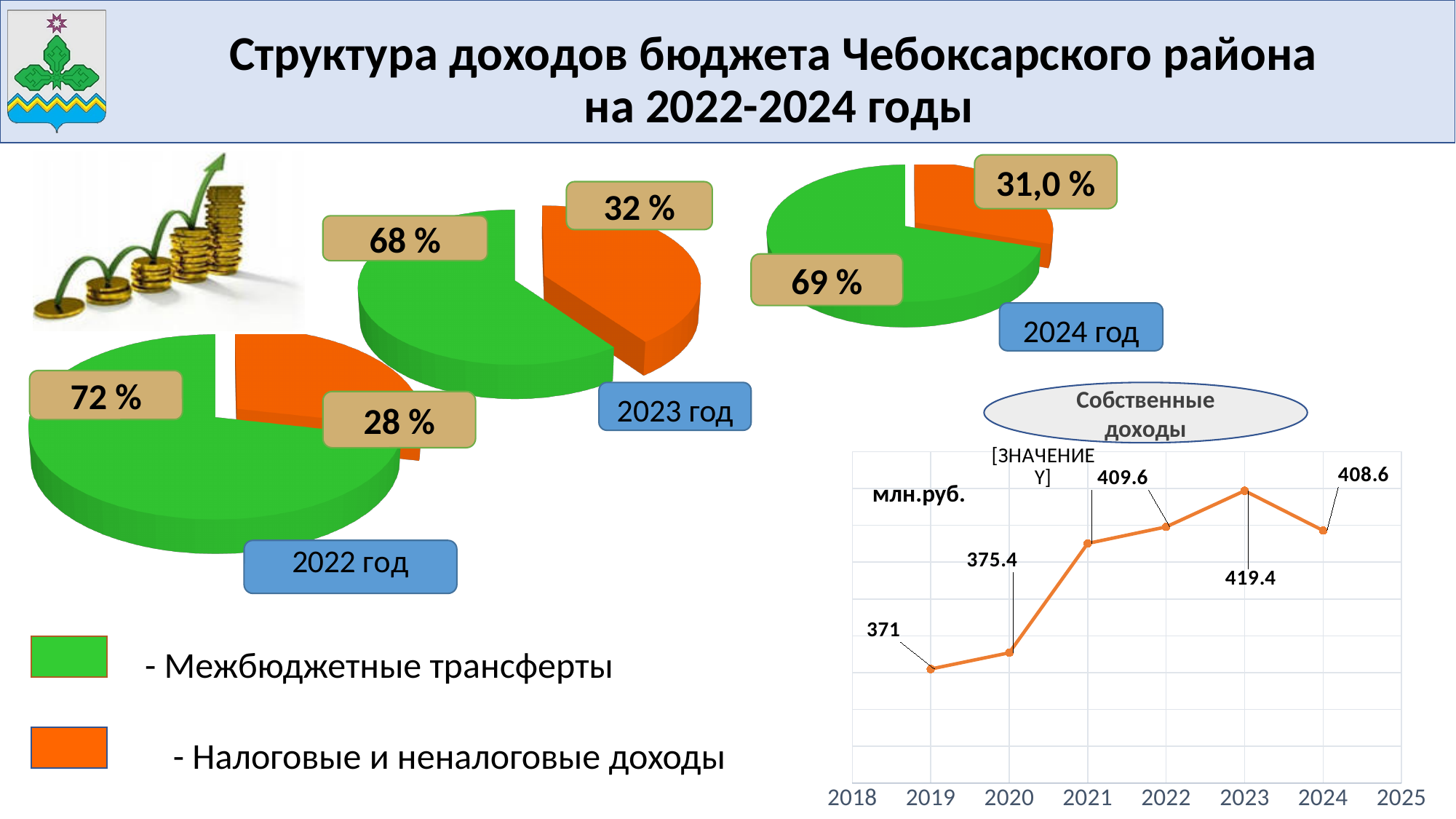
In the 2024 год pie chart, which category has the larger slice? Межбюджетные трансферты In the Собственные доходы line chart, which year has the highest value? 2023 In the Собственные доходы line chart, what is the value for 2019? 371 In the Собственные доходы line chart, what is the value for 2024? 408.6 In the Собственные доходы line chart, what is the value for 2023? 419.4 What colour represents Межбюджетные трансферты in the pie charts? Green In the 2022 год pie chart, what share is Межбюджетные трансферты? 72 % In the Собственные доходы line chart, how many data points are plotted? 6 In the Собственные доходы line chart, what is the difference between the 2023 and 2024 values? 10.8 In the 2023 год pie chart, what share is Налоговые и неналоговые доходы? 32 % In the Собственные доходы line chart, which year has the lowest value? 2019 In the 2024 год pie chart, what share is Налоговые и неналоговые доходы? 31,0 %